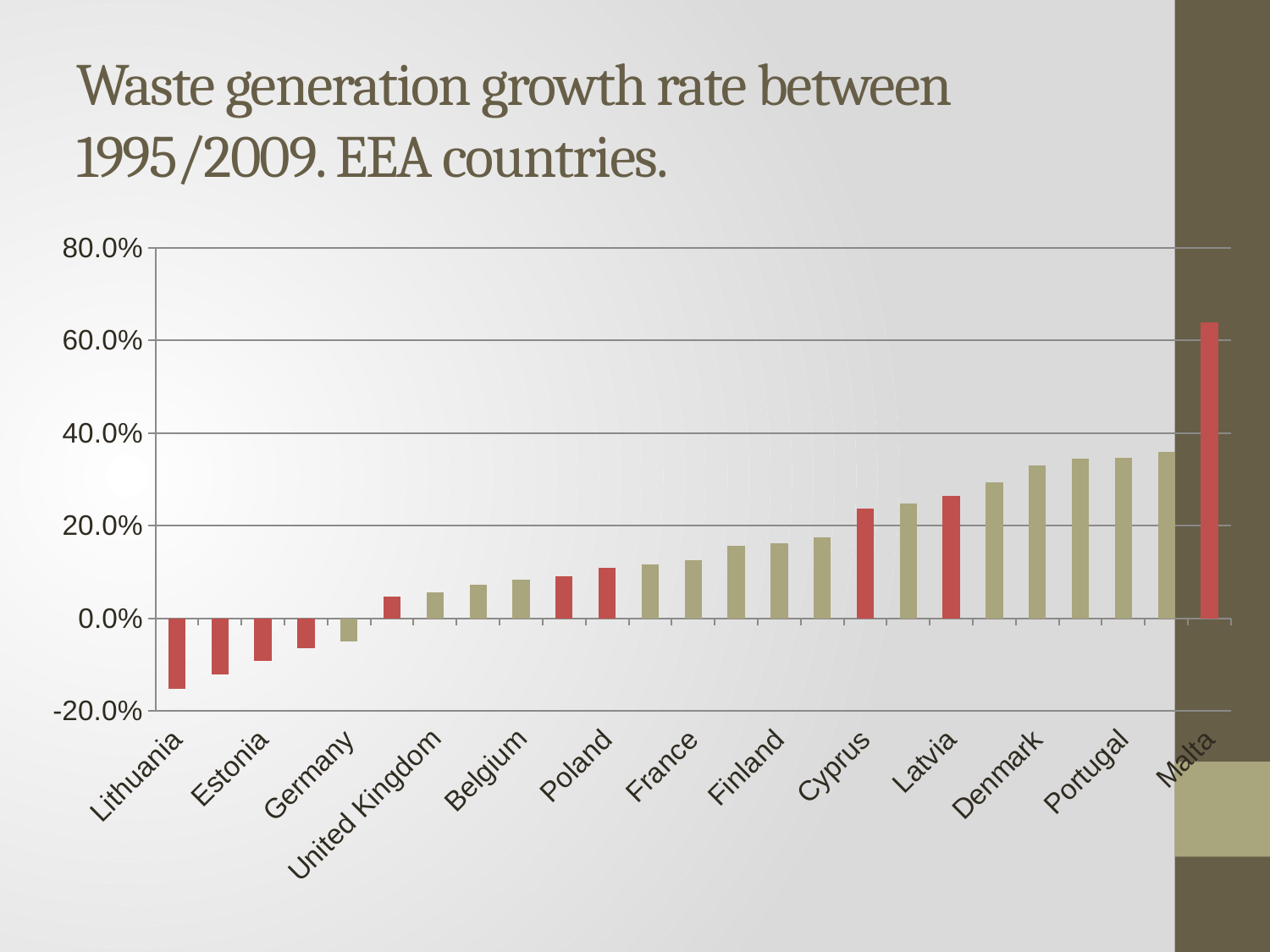
Is the value for Portugal greater or less than 40.0%? less Do the values generally rise or fall from left to right along the x axis? rise How many bars are plotted in the chart? 25 What is the title of the chart on the slide? Waste generation growth rate between 1995/2009. EEA countries. Which has the larger growth rate, Denmark or Finland? Denmark Which country has the lowest waste generation growth rate? Lithuania Is the value for Malta greater or less than 60.0%? greater Which country has the highest waste generation growth rate? Malta What kind of chart is shown on the slide? bar chart Is the value for Denmark greater or less than 20.0%? greater